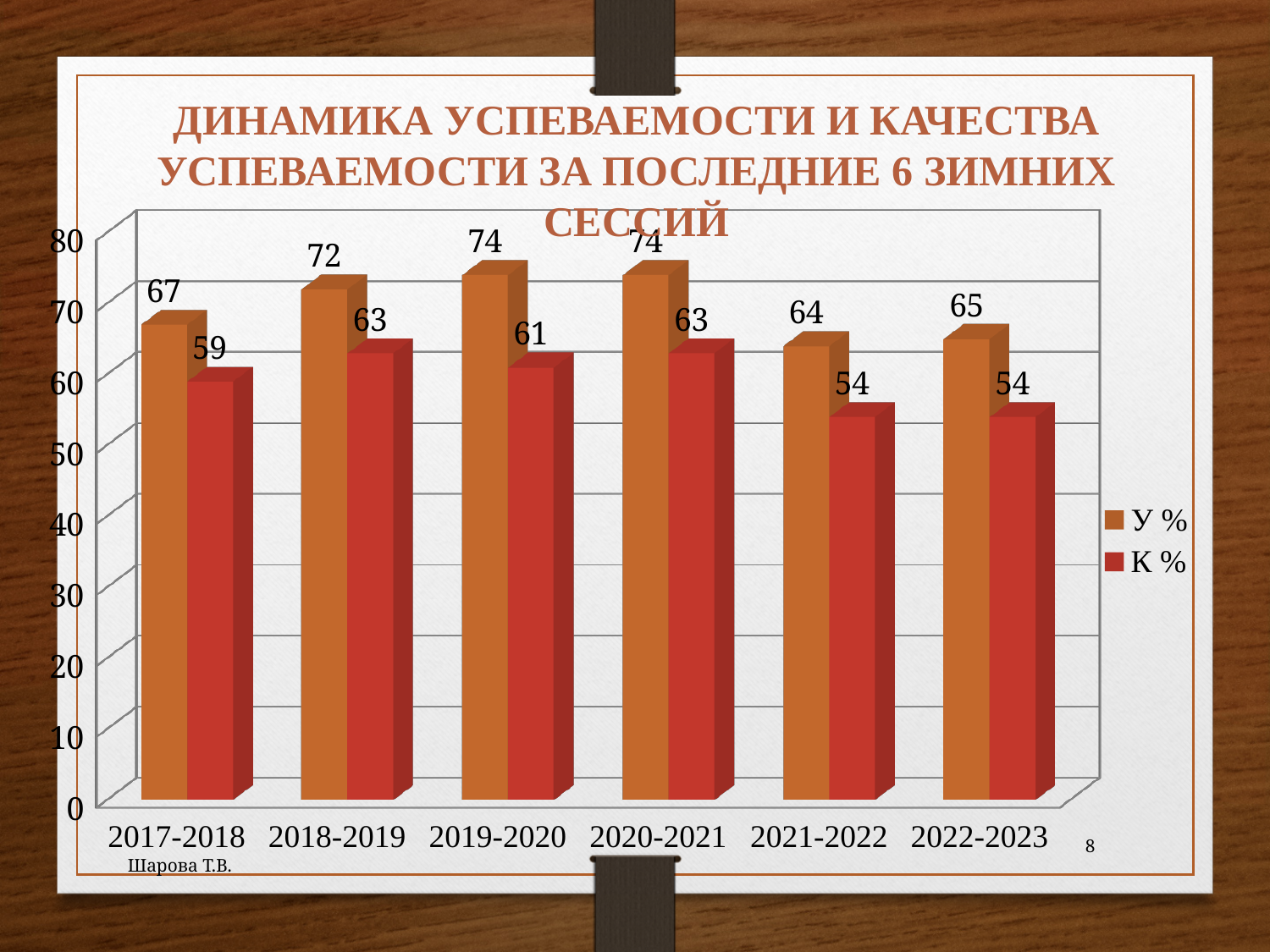
What kind of chart is shown on the slide? Bar chart What is the value of К % for 2022-2023? 54 Which category has the highest К % value? 2018-2019 and 2020-2021 Which is larger: У % for 2018-2019 or У % for 2022-2023? У % for 2018-2019 How many series does the legend list? 2 Does the К % value rise or fall from 2020-2021 to 2021-2022? Fall What is the value of К % for 2019-2020? 61 What is the value of У % for 2017-2018? 67 What is the difference between У % and К % for 2020-2021? 11 What is the value of У % for 2021-2022? 64 How many categories are shown on the x axis? 6 Which category has the lowest У % value? 2021-2022